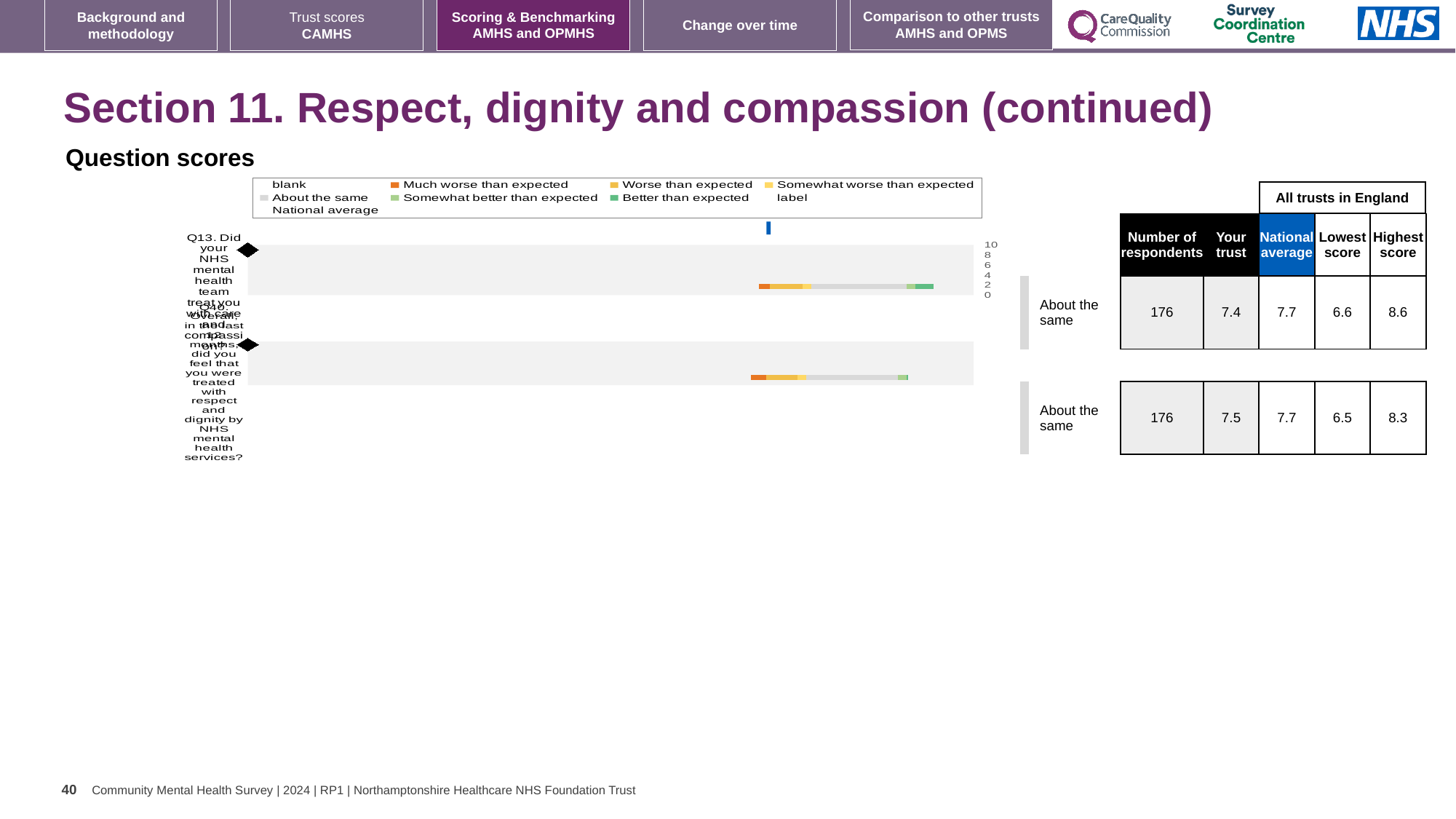
How many questions (categories) are plotted in the question scores chart? 2 What is the 'Your trust' score for Q10 (treated with respect and dignity)? 7.5 What is the national average score for Q13? 7.7 What is the highest value shown on the chart's axis? 10 What is the difference between the highest score and the lowest score for Q13? 2.0 How many respondents answered Q10? 176 What kind of chart is used to show the question scores? bar chart What is the highest score among all trusts in England for Q10? 8.3 What is the 'Your trust' score for Q13 (treated with care and compassion)? 7.4 Which question has the higher 'Your trust' score, Q13 or Q10? Q10 How many entries does the legend of the question scores chart list? 9 What is the lowest score among all trusts in England for Q13? 6.6